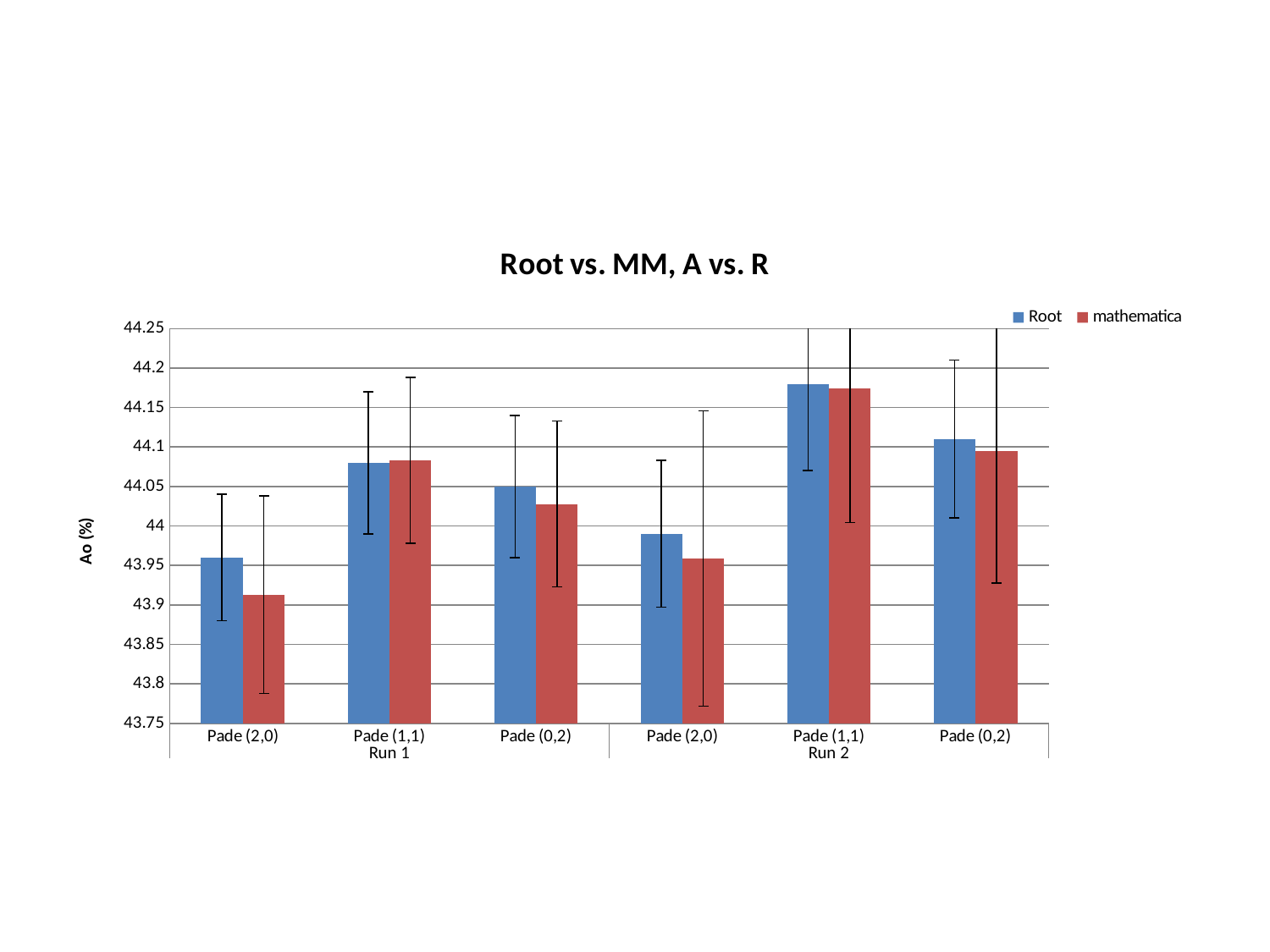
For Pade (2,0) in Run 2, which is larger, the Root value or the mathematica value? Root Is the Root value for Pade (1,1) in Run 2 greater or less than 44.15? greater How many category groups (pairs of bars) are plotted along the x axis? 6 How many series does the legend list? 2 Which category has the lowest Root value? Pade (2,0) in Run 1 Which category has the highest Root value? Pade (1,1) in Run 2 What is the label on the vertical axis? Ao (%) What is the title of the chart? Root vs. MM, A vs. R Which category has the lowest mathematica value? Pade (2,0) in Run 1 For Pade (2,0) in Run 1, which is larger, the Root value or the mathematica value? Root Is the mathematica value for Pade (2,0) in Run 1 greater or less than 43.95? less What kind of chart is shown on the slide? bar chart